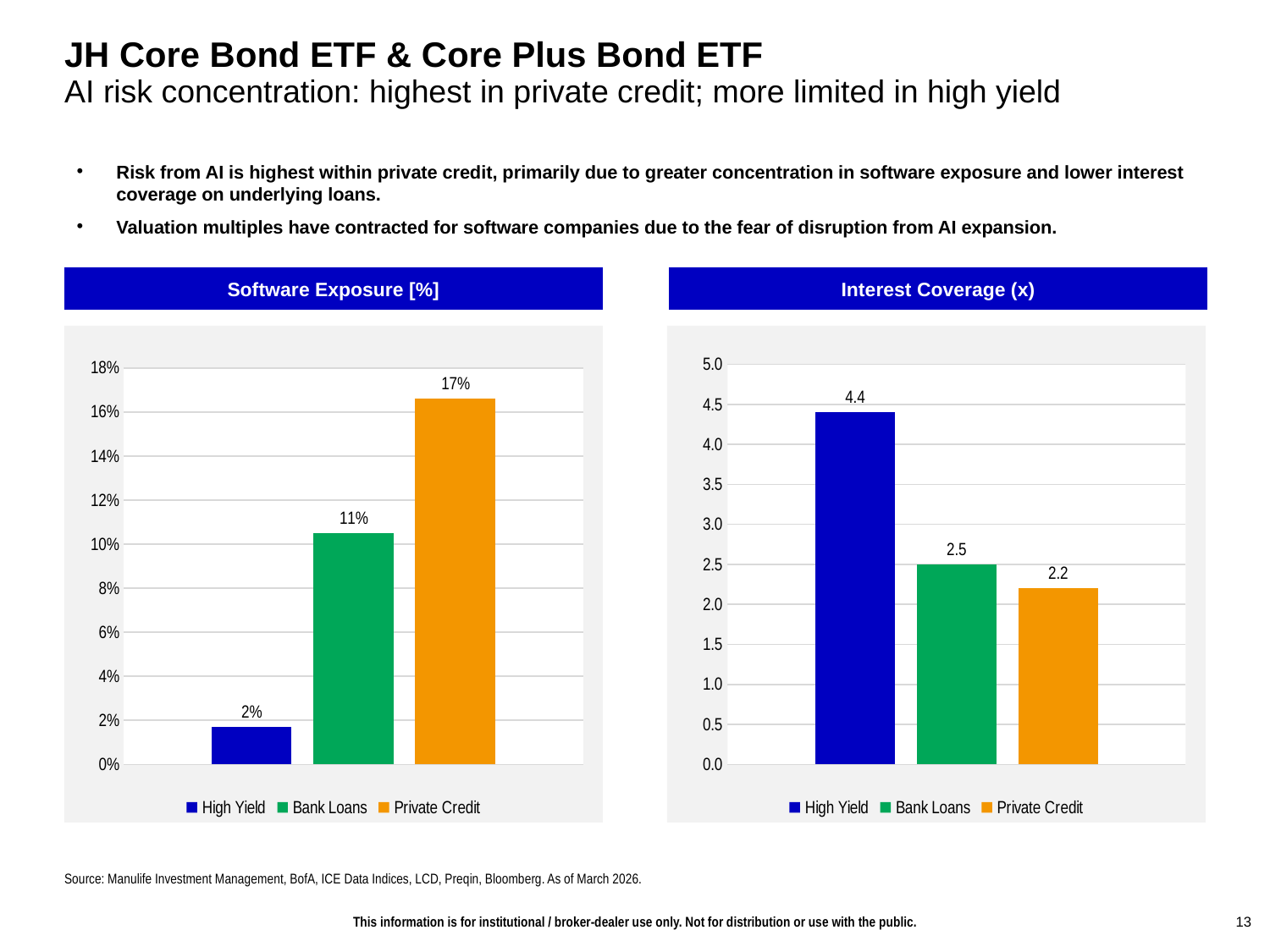
In the Software Exposure [%] chart, which category has the highest value? Private Credit In the Interest Coverage (x) chart, is the value for High Yield greater or less than 4.0? greater In the Software Exposure [%] chart, what is the value for High Yield? 2% In the Software Exposure [%] chart, which is larger, Bank Loans or High Yield? Bank Loans What kind of chart is the Interest Coverage (x) chart? Bar chart In the Interest Coverage (x) chart, what is the value for High Yield? 4.4 How many series does the legend of the Interest Coverage (x) chart list? 3 In the Interest Coverage (x) chart, what is the value for Bank Loans? 2.5 In the Software Exposure [%] chart, what is the value for Private Credit? 17% In the Interest Coverage (x) chart, what is the difference between High Yield and Private Credit? 2.2 How many bars are shown in the Software Exposure [%] chart? 3 In the Interest Coverage (x) chart, which category has the lowest value? Private Credit